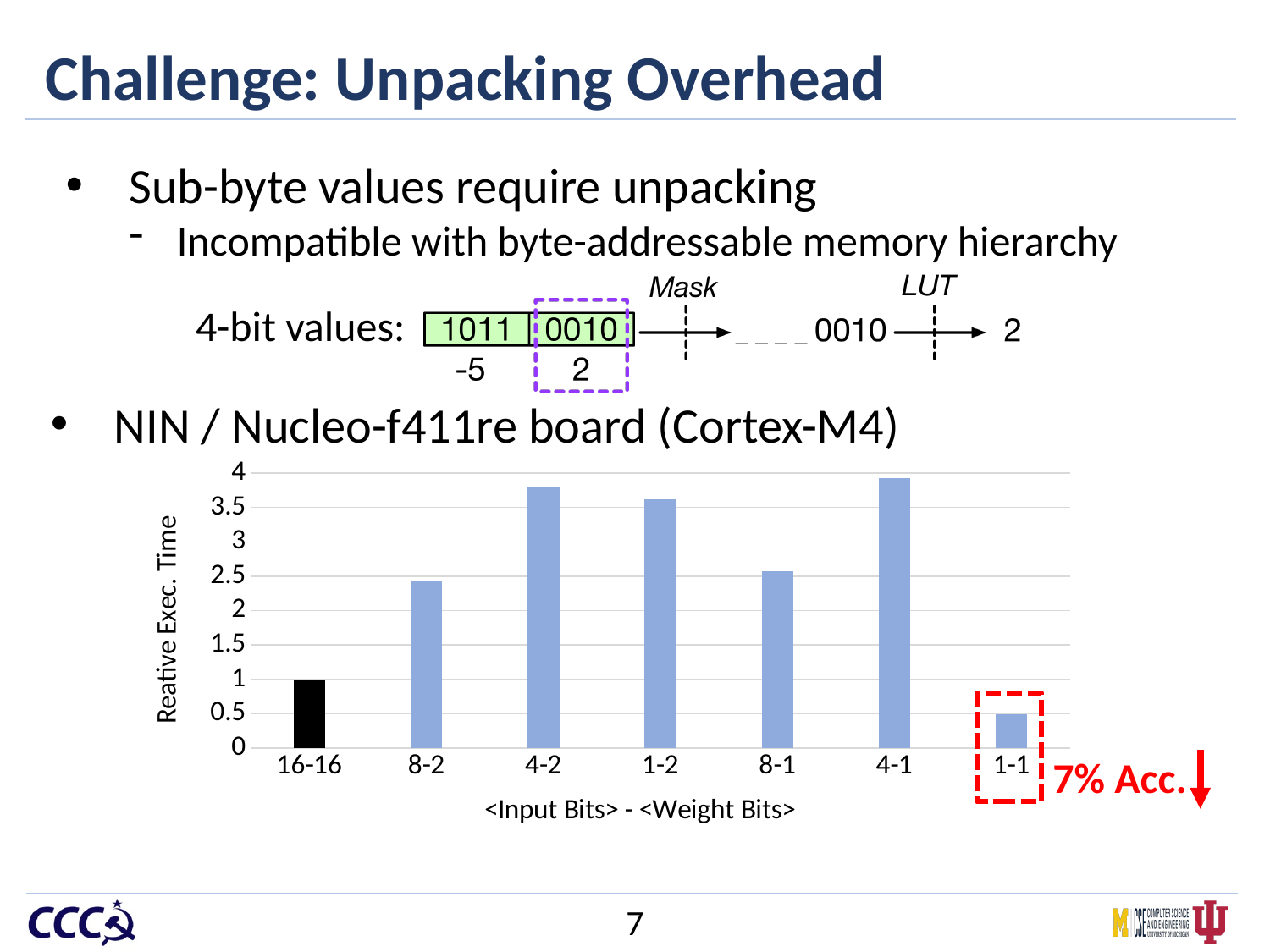
Which category's bar is coloured black rather than blue? 16-16 Which has a higher relative execution time, 8-1 or 1-2? 1-2 What is the label on the x axis of the chart? <Input Bits> - <Weight Bits> Which has a higher relative execution time, 8-2 or 4-2? 4-2 Which configuration has the lowest relative execution time? 1-1 Is the value for 4-1 greater or less than 3.5? greater Is the value for 8-2 greater or less than 2? greater What type of chart is shown on the slide? bar chart How many categories are shown on the x axis of the chart? 7 What is the relative execution time for the 16-16 configuration? 1 Is the value for 1-1 greater or less than 1? less